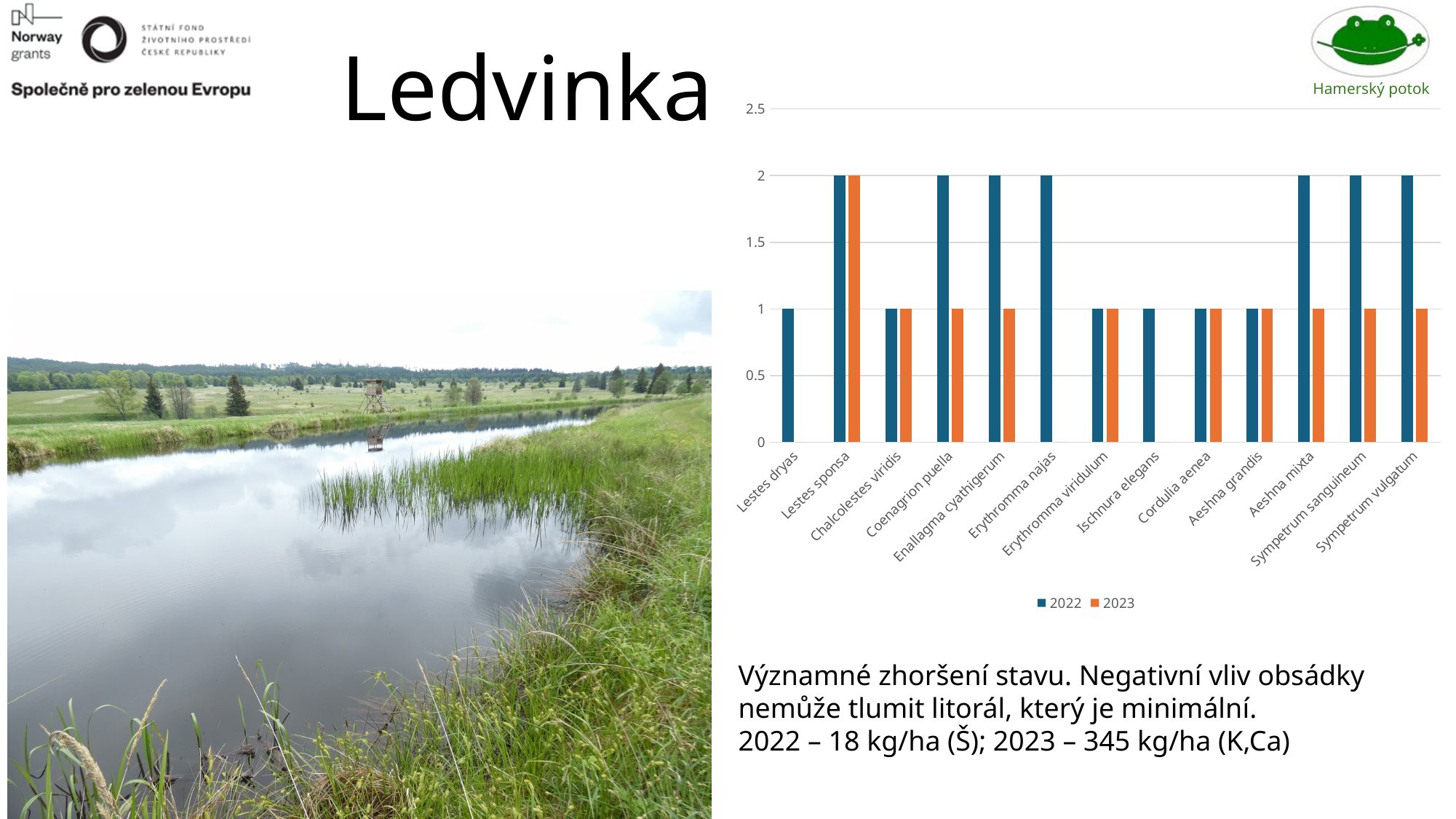
What is the 2022 value for Ischnura elegans? 1 Is the 2022 value for Enallagma cyathigerum greater or less than 1.5? greater What is the 2023 value for Aeshna grandis? 1 Which series is shown in orange in the chart legend? 2023 What type of chart is shown on the slide? bar chart What is the 2022 value for Lestes sponsa? 2 Which is larger for Aeshna mixta, the 2022 value or the 2023 value? 2022 What is the 2023 value for Coenagrion puella? 1 What is the difference between the 2022 and 2023 values for Sympetrum vulgatum? 1 How many series does the chart legend list? 2 How many species categories are shown on the x axis of the chart? 13 What is the 2022 value for Erythromma najas? 2